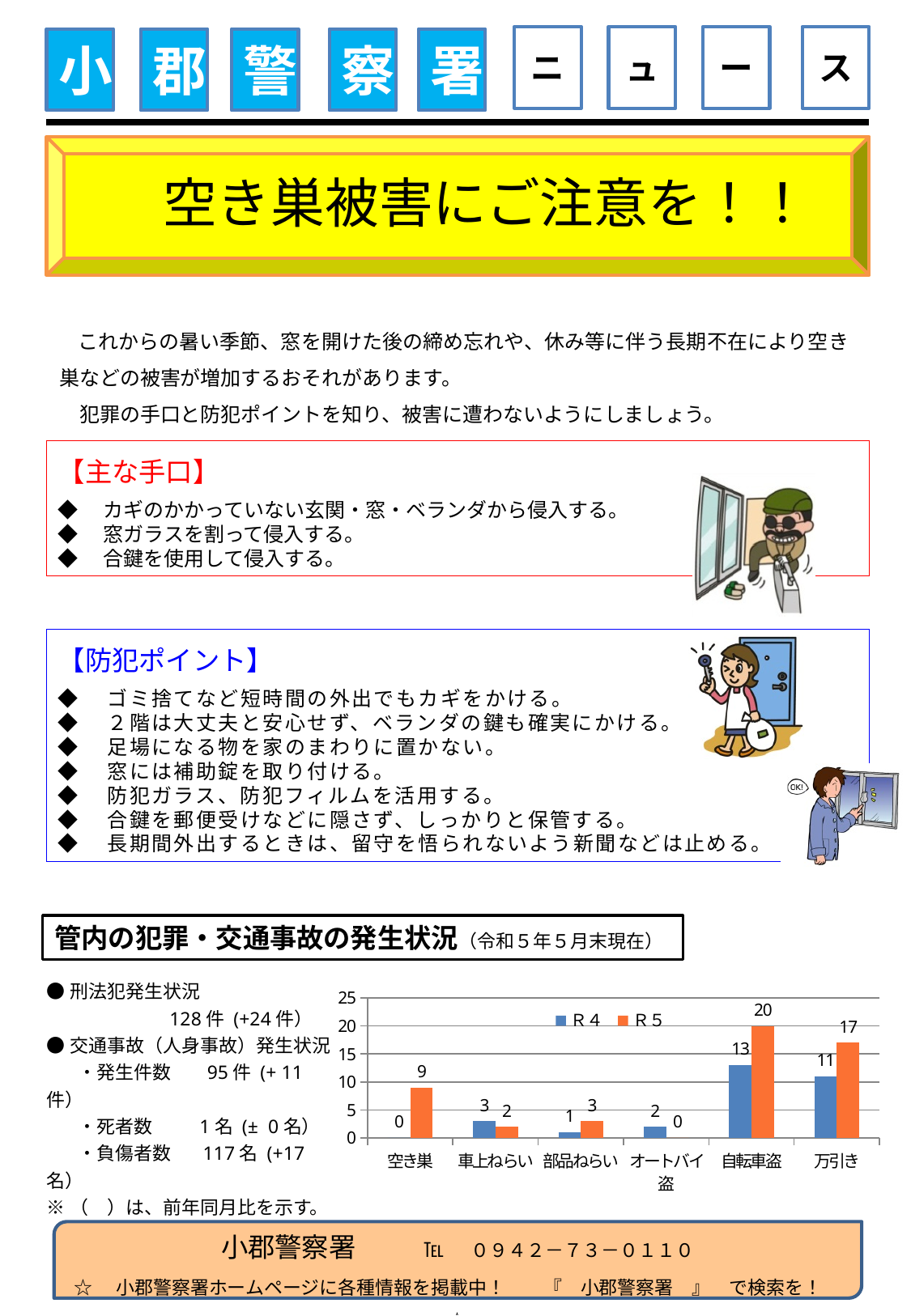
What is the R5 value for 万引き? 17 What kind of chart is shown on the slide? bar chart What is the difference between the R5 and R4 values for 自転車盗? 7 What is the R4 value for オートバイ盗? 2 For 車上ねらい, which is larger, the R4 value or the R5 value? R4 Is the R5 value for 自転車盗 greater or less than 15? greater What is the R4 value for 自転車盗? 13 What is the R5 value for 空き巣? 9 Which category has the lowest R4 value? 空き巣 Which category has the highest R5 value? 自転車盗 How many categories are shown on the x axis of the chart? 6 How many series does the chart legend list? 2